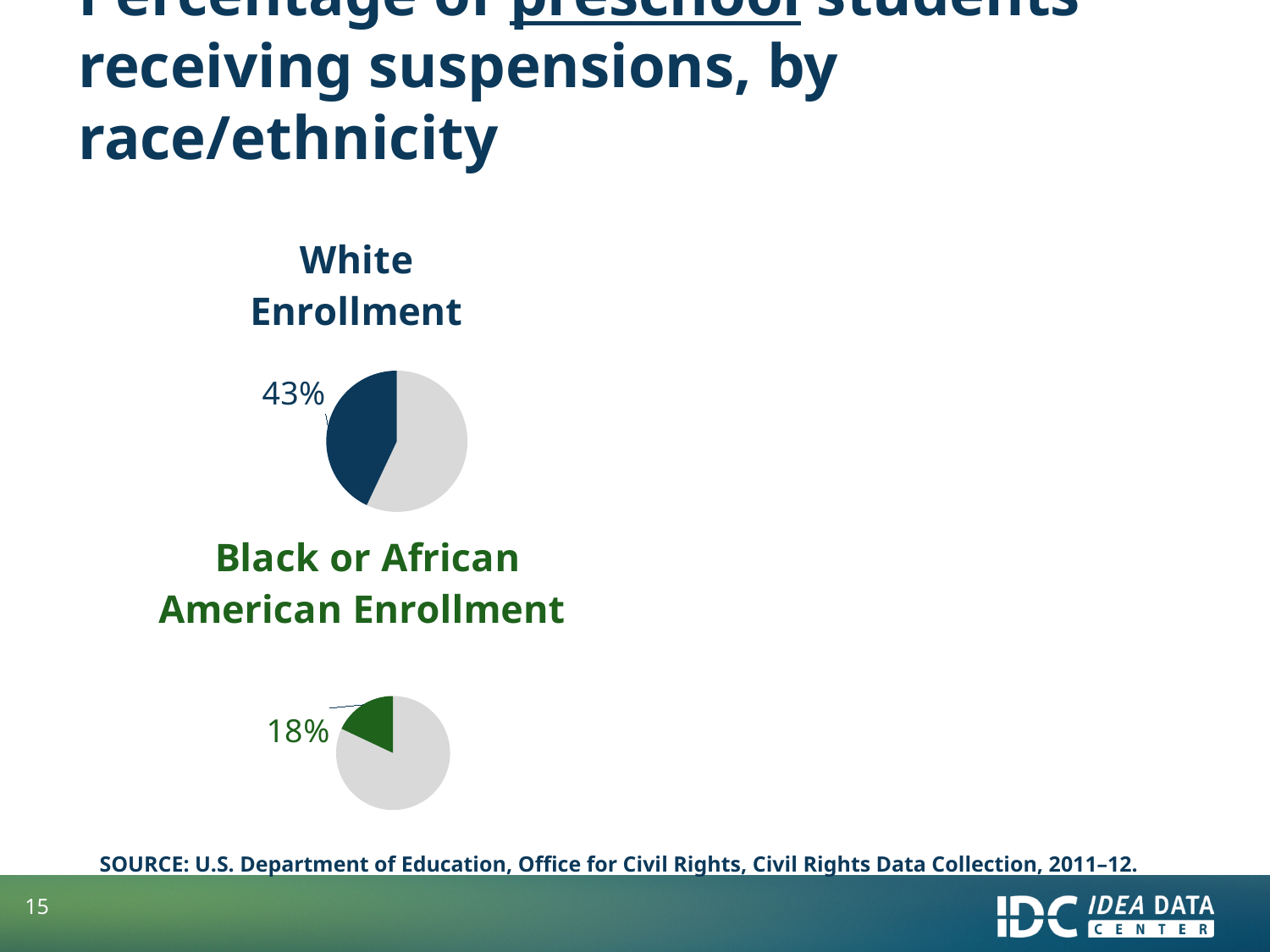
Which pie chart has the larger labeled slice, White Enrollment or Black or African American Enrollment? White Enrollment What type of chart is used to show the White Enrollment data? Pie chart In the White Enrollment pie chart, what share of the pie does the dark blue slice represent? 43% In the Black or African American Enrollment pie chart, what share of the pie does the green slice represent? 18% What is the difference in percentage points between the labeled slice in the White Enrollment chart (43%) and the labeled slice in the Black or African American Enrollment chart (18%)? 25 percentage points What colour is the labeled slice in the White Enrollment pie chart? Dark blue Is the labeled slice in the White Enrollment pie chart greater or less than 50% of the pie? less What colour is the labeled slice in the Black or African American Enrollment pie chart? Green In the White Enrollment pie chart, what percentage is shown for the highlighted slice? 43% In the Black or African American Enrollment pie chart, what percentage is shown for the highlighted slice? 18% How many pie charts are shown on the slide? 2